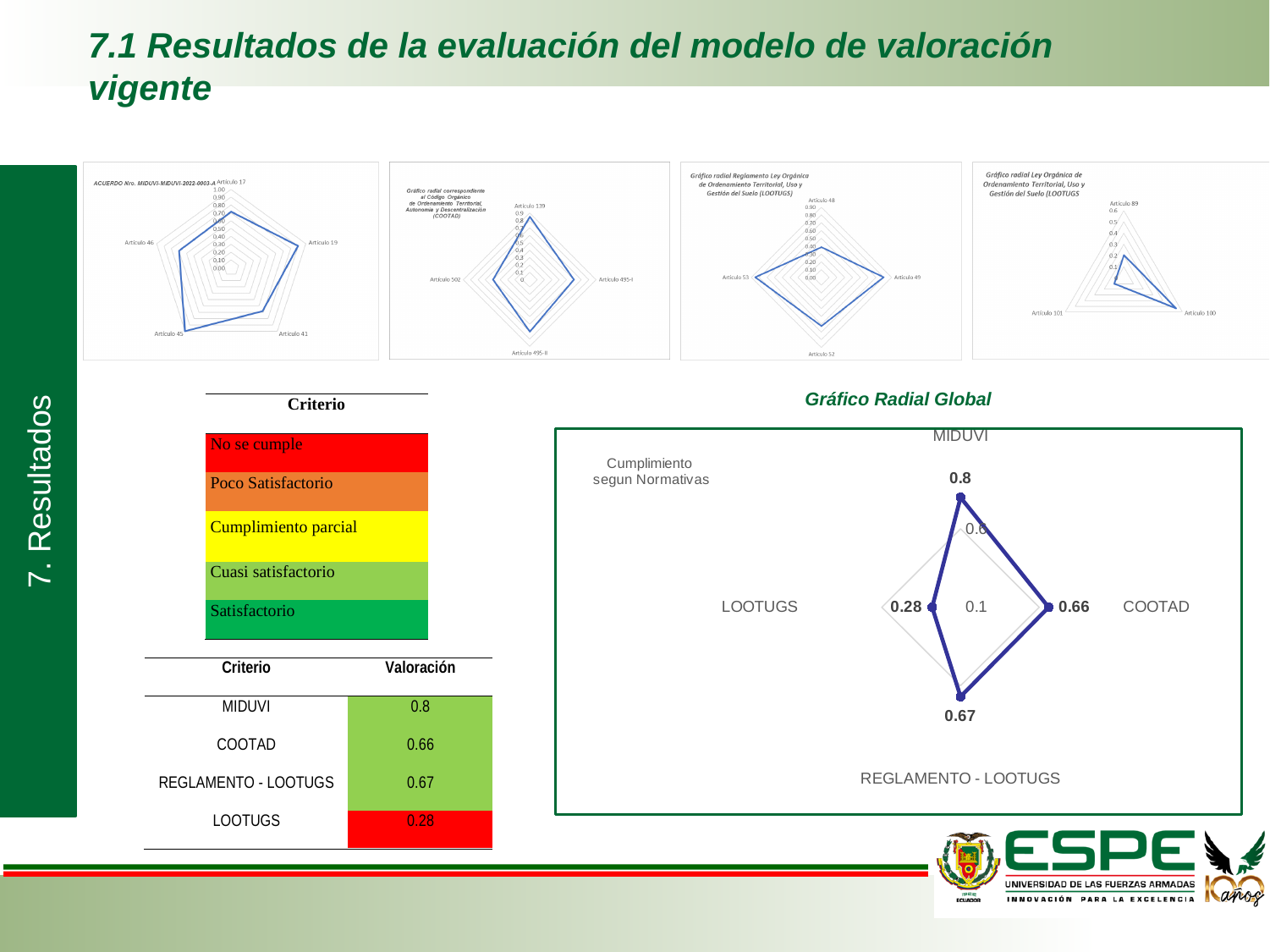
How many categories are plotted in the Gráfico Radial Global chart? 4 In the Gráfico Radial Global chart, what is the value for COOTAD? 0.66 In the Gráfico Radial Global chart, what is the difference between the values for MIDUVI and LOOTUGS? 0.52 In the Gráfico Radial Global chart, what is the value for REGLAMENTO - LOOTUGS? 0.67 In the Gráfico Radial Global chart, which is larger, the value for COOTAD or the value for REGLAMENTO - LOOTUGS? REGLAMENTO - LOOTUGS What kind of chart is the Gráfico Radial Global? Radar chart In the Gráfico Radial Global chart, which category has the highest value? MIDUVI In the Gráfico Radial Global chart, which category has the lowest value? LOOTUGS In the Gráfico Radial Global chart, what is the value for MIDUVI? 0.8 In the Gráfico Radial Global chart, is the value for LOOTUGS greater or less than 0.6? less In the Gráfico Radial Global chart, what is the value for LOOTUGS? 0.28 How many categories (artículos) are plotted in the top-left radar chart titled ACUERDO Nro. MIDUVI-MIDUVI-2022-0003-A? 5